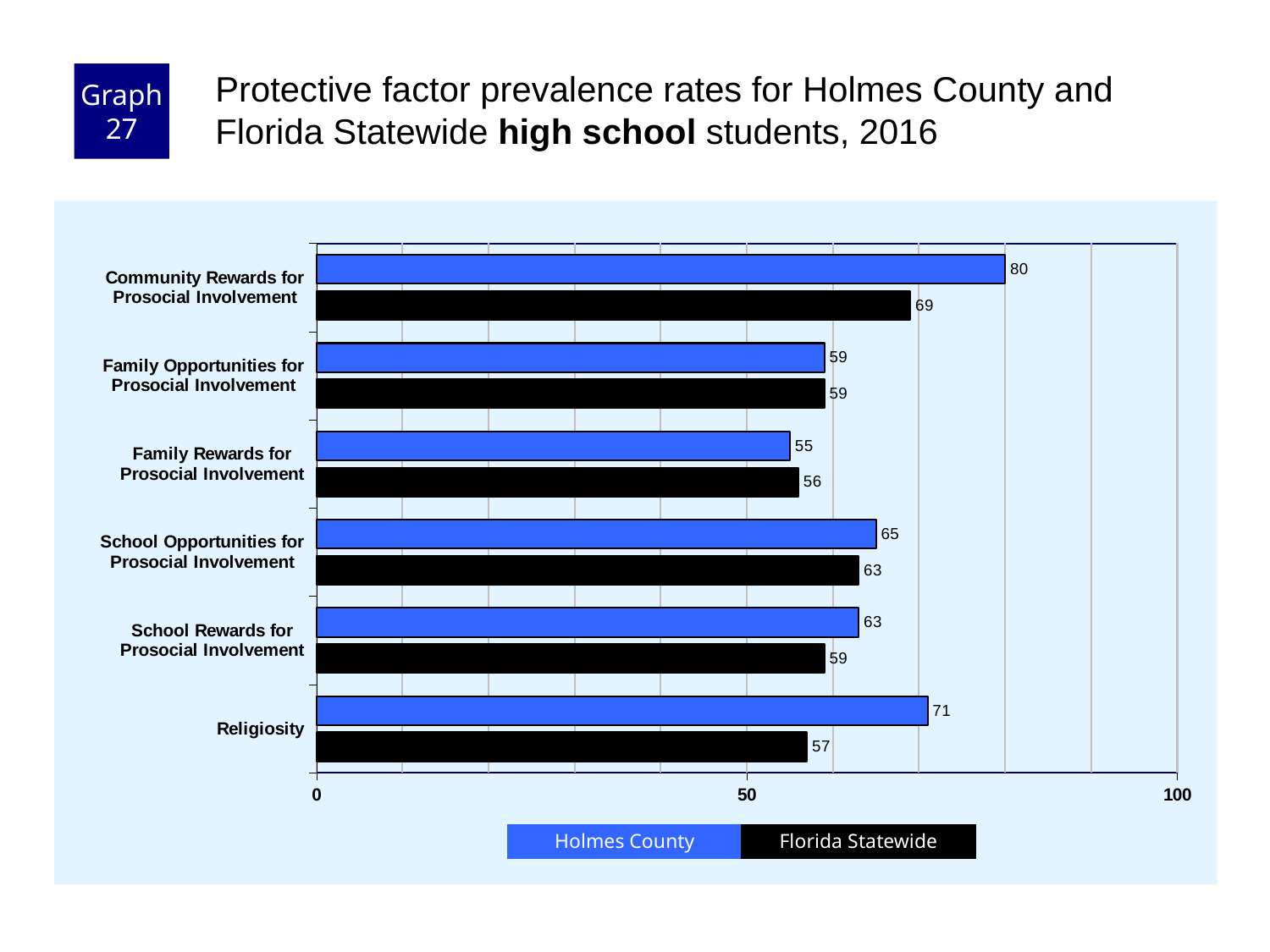
What is the Florida Statewide value for Religiosity? 57 Is the Holmes County value for Religiosity greater or less than 50? greater What kind of chart is shown on the slide? Bar chart Which category has the lowest Holmes County value? Family Rewards for Prosocial Involvement What is the difference between the Holmes County and Florida Statewide values for Community Rewards for Prosocial Involvement? 11 For School Rewards for Prosocial Involvement, which is larger: the Holmes County value or the Florida Statewide value? Holmes County How many series does the legend list? 2 What is the Florida Statewide value for School Opportunities for Prosocial Involvement? 63 How many categories are shown on the chart? 6 What is the Holmes County value for Community Rewards for Prosocial Involvement? 80 Which category has the highest Holmes County value? Community Rewards for Prosocial Involvement What is the difference between the Holmes County and Florida Statewide values for Religiosity? 14